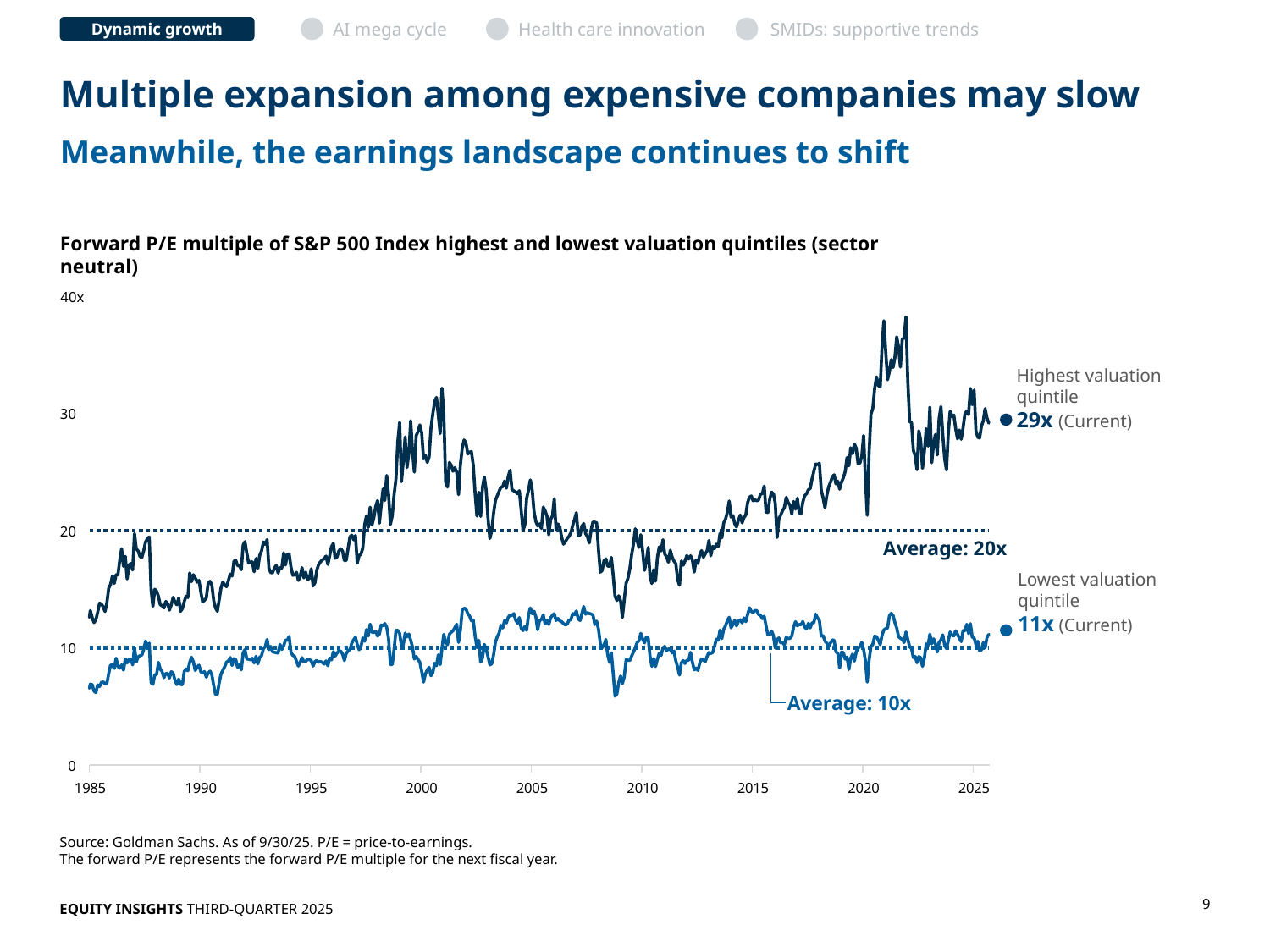
Does the forward P/E of the highest valuation quintile rise or fall between 2010 and 2021? Rise What is the average forward P/E multiple shown for the lowest valuation quintile? 10x What is the difference between the average forward P/E of the highest valuation quintile and the average of the lowest valuation quintile? 10x How many series are plotted on the chart? 2 What is the average forward P/E multiple shown for the highest valuation quintile? 20x Is the peak value of the highest valuation quintile around 2021 greater or less than 30? greater What is the current forward P/E multiple of the highest valuation quintile? 29x Which quintile currently has the higher forward P/E multiple, the highest valuation quintile or the lowest valuation quintile? Highest valuation quintile What is the difference between the current forward P/E of the highest valuation quintile and that of the lowest valuation quintile? 18x What kind of chart is shown on the slide? Line chart What is the current forward P/E multiple of the lowest valuation quintile? 11x Is the value of the lowest valuation quintile at its 2009 low greater or less than 10? less